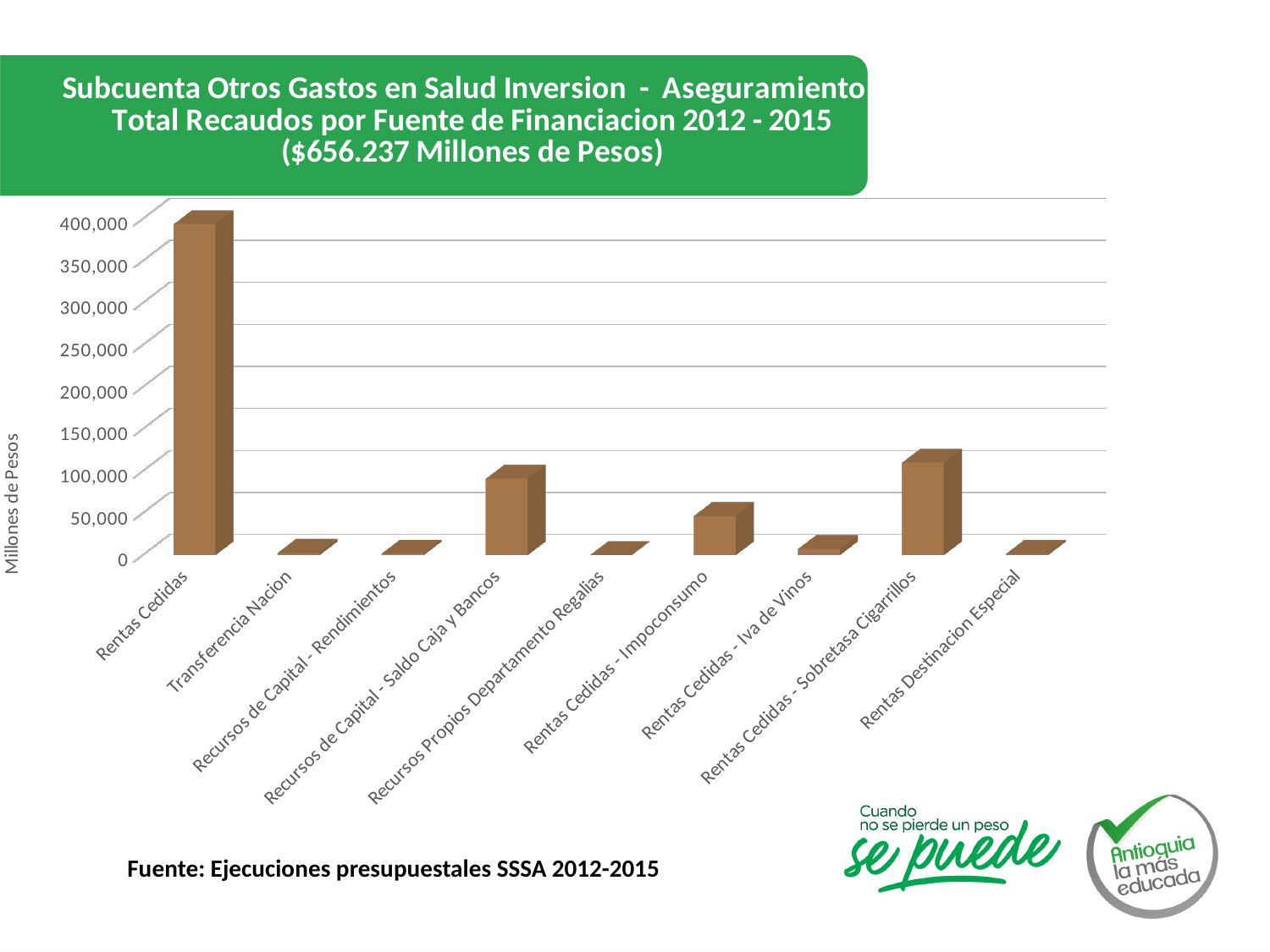
What total amount is stated in the chart title? $656.237 Millones de Pesos What is the label of the vertical axis? Millones de Pesos Which is larger, the value for Rentas Cedidas or the value for Rentas Cedidas - Sobretasa Cigarrillos? Rentas Cedidas Which is larger, the value for Rentas Cedidas - Impoconsumo or the value for Rentas Cedidas - Iva de Vinos? Rentas Cedidas - Impoconsumo Which funding source has the highest total recaudos? Rentas Cedidas How many funding source categories are plotted on the x axis? 9 Is the value for Rentas Cedidas greater or less than 350,000? greater What kind of chart is shown on the slide? Bar chart Is the value for Rentas Cedidas - Impoconsumo greater or less than 100,000? less Is the value for Recursos de Capital - Saldo Caja y Bancos greater or less than 100,000? less Which is larger, the value for Rentas Cedidas - Sobretasa Cigarrillos or the value for Recursos de Capital - Saldo Caja y Bancos? Rentas Cedidas - Sobretasa Cigarrillos